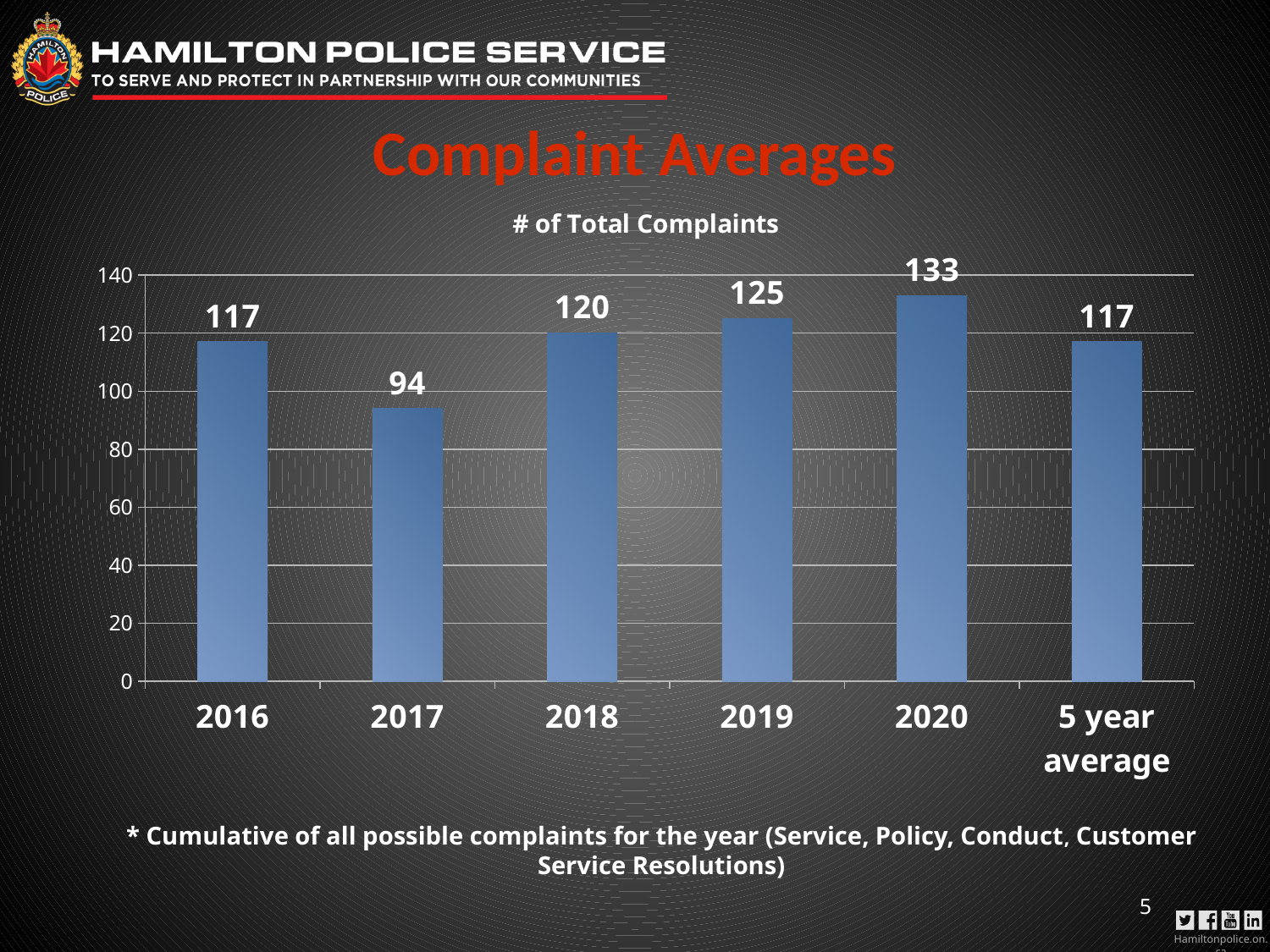
Which has more total complaints, 2018 or 2019? 2019 Is the value for 2017 greater or less than 100? less What is the difference in total complaints between 2020 and 2017? 39 What is the number of total complaints for 2017? 94 What is the number of total complaints for 2020? 133 Which year has the lowest number of total complaints? 2017 What is the title of the chart? # of Total Complaints What is the difference in total complaints between 2019 and 2018? 5 What is the value shown for the 5 year average? 117 Which year has the highest number of total complaints? 2020 What kind of chart is shown on the slide? bar chart How many bars are shown in the chart? 6